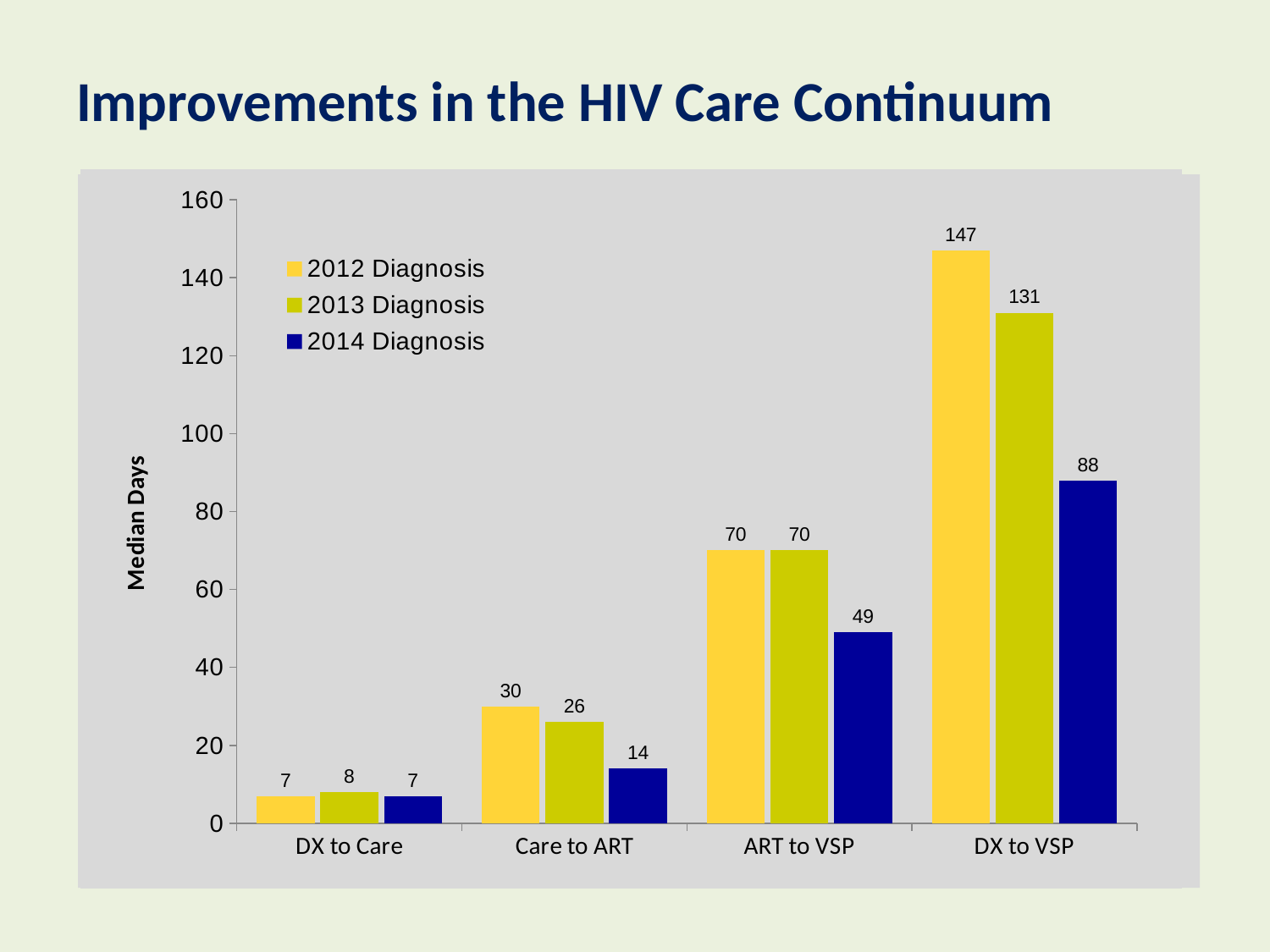
What is the median days value for 2013 Diagnosis in the DX to Care category? 8 What is the difference between the 2013 Diagnosis and 2014 Diagnosis values for ART to VSP? 21 What is the median days value for 2012 Diagnosis in the Care to ART category? 30 Is the 2013 Diagnosis value for DX to VSP greater or less than 120? greater Which category has the highest value for 2012 Diagnosis? DX to VSP How many categories are shown on the x axis? 4 Which is larger: the 2013 Diagnosis value for Care to ART or the 2014 Diagnosis value for Care to ART? 2013 Diagnosis What is the difference between the 2012 Diagnosis and 2014 Diagnosis values for DX to VSP? 59 How many series does the legend list? 3 What kind of chart is shown on the slide? Bar chart Which category has the lowest value for 2014 Diagnosis? DX to Care What is the median days value for 2014 Diagnosis in the DX to VSP category? 88